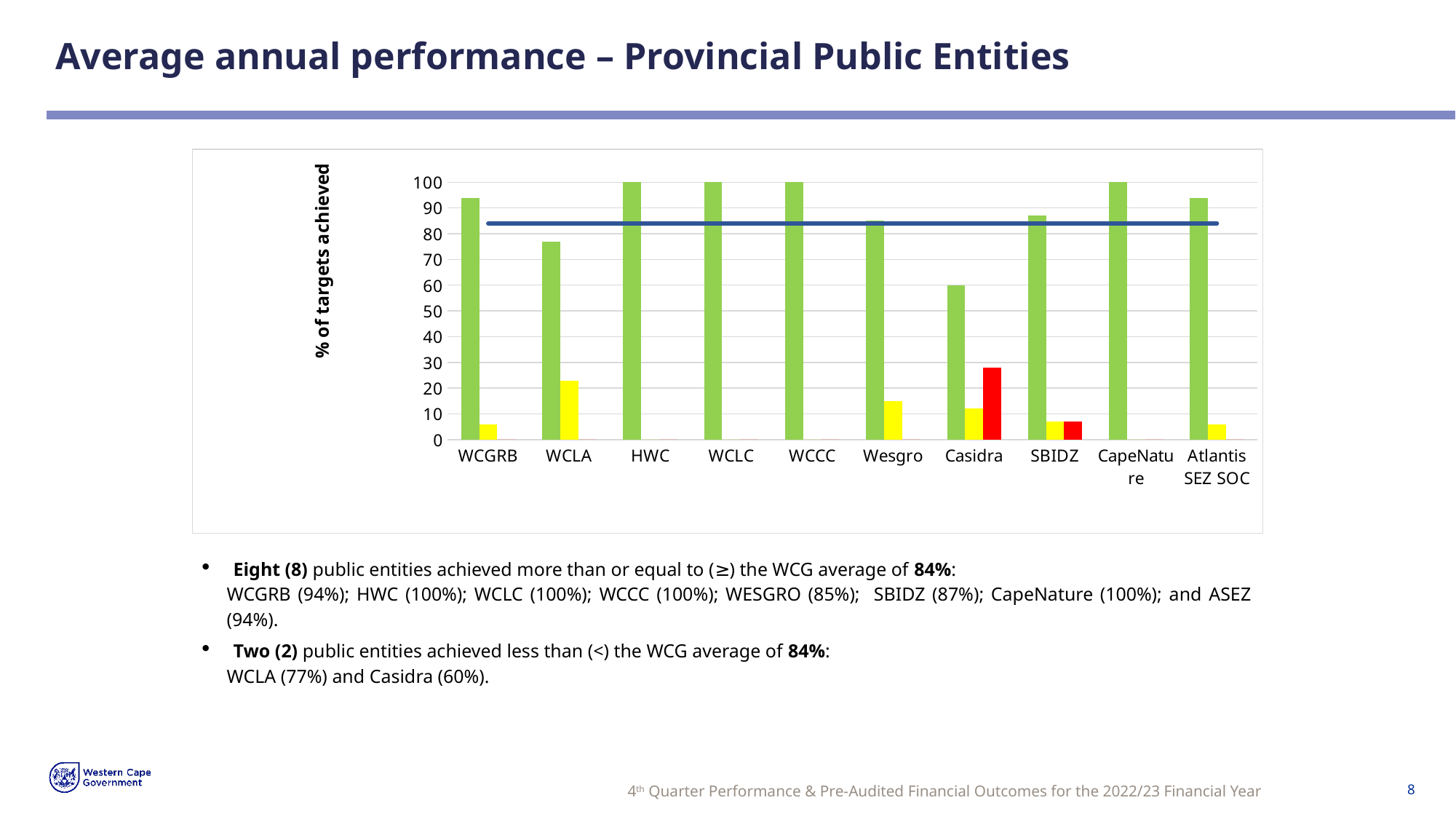
Which entity has the lowest green bar? Casidra Is the green bar for WCGRB greater or less than 90? greater What is the value of the green bar for Casidra? 60 How many public entities are shown along the x axis of the chart? 10 Is the red bar for Casidra greater or less than 30? less Which has the taller red bar, Casidra or SBIDZ? Casidra What kind of chart is shown on the slide? bar chart How many entities have a red bar in the chart? 2 What is the label on the vertical axis of the chart? % of targets achieved Which has the taller yellow bar, WCLA or WCGRB? WCLA Is the green bar for WCLA greater or less than 80? less What is the value of the green bar for HWC? 100